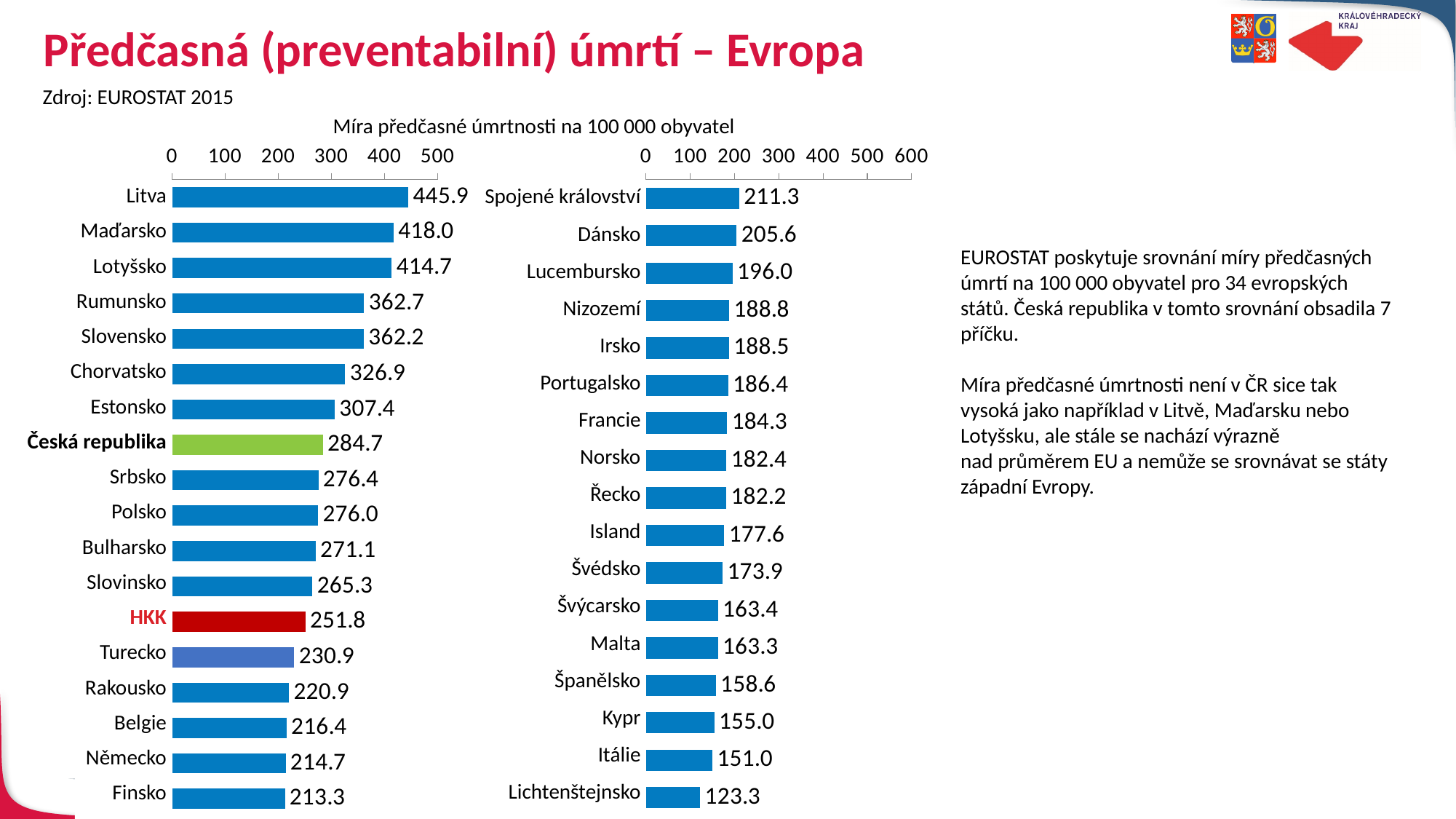
In the left chart, which category has the highest value? Litva How many categories does the right chart show? 17 In the left chart, what is the value for Česká republika? 284.7 In the left chart, what is the value for HKK? 251.8 In the right chart, what is the difference between the values for Spojené království and Dánsko? 5.7 In the right chart, what is the value for Francie? 184.3 What kind of chart is the left chart? bar chart In the left chart, which is larger, the value for Rumunsko or the value for Chorvatsko? Rumunsko In the right chart, which category has the lowest value? Lichtenštejnsko How many categories does the left chart show? 18 In the left chart, what is the difference between the values for Litva and Maďarsko? 27.9 In the right chart, is the value for Itálie greater or less than 200? less